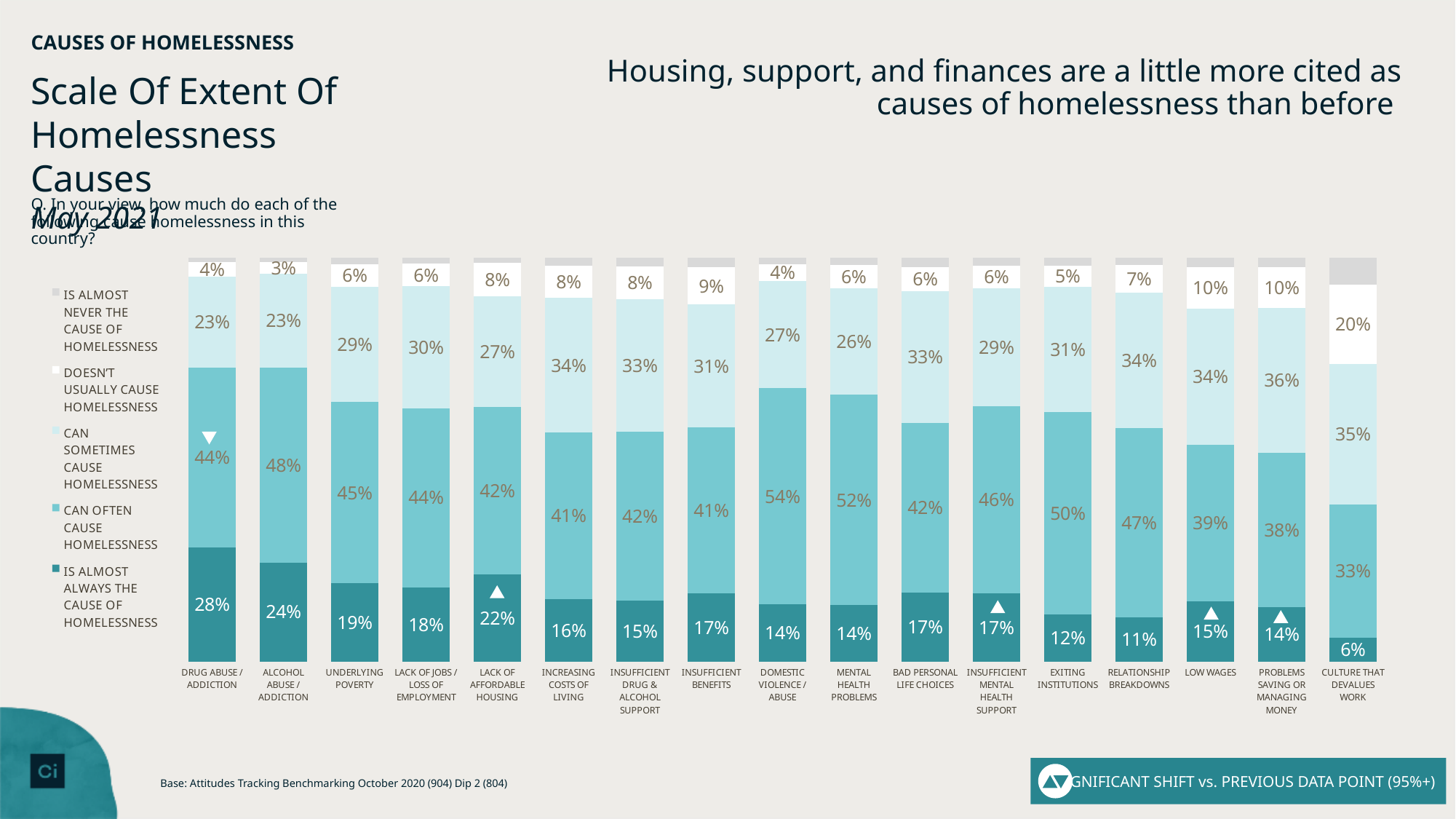
Which cause has the lowest share of respondents saying it is almost always the cause of homelessness? Culture that devalues work Which cause has the highest share of respondents saying it is almost always the cause of homelessness? Drug abuse / addiction How many causes of homelessness are shown on the chart? 17 What type of chart is shown on the slide? Stacked bar chart Which has a larger share for 'is almost always the cause of homelessness': lack of affordable housing or low wages? Lack of affordable housing Which cause has the highest share of respondents saying it can often cause homelessness? Domestic violence / abuse What percentage said problems saving or managing money can sometimes cause homelessness? 36% What is the difference in percentage points between drug abuse / addiction and alcohol abuse / addiction for 'is almost always the cause of homelessness'? 4 percentage points What percentage said a culture that devalues work doesn't usually cause homelessness? 20% What percentage said domestic violence / abuse can often cause homelessness? 54% What percentage of respondents said drug abuse / addiction is almost always the cause of homelessness? 28% How many series does the legend list? 5